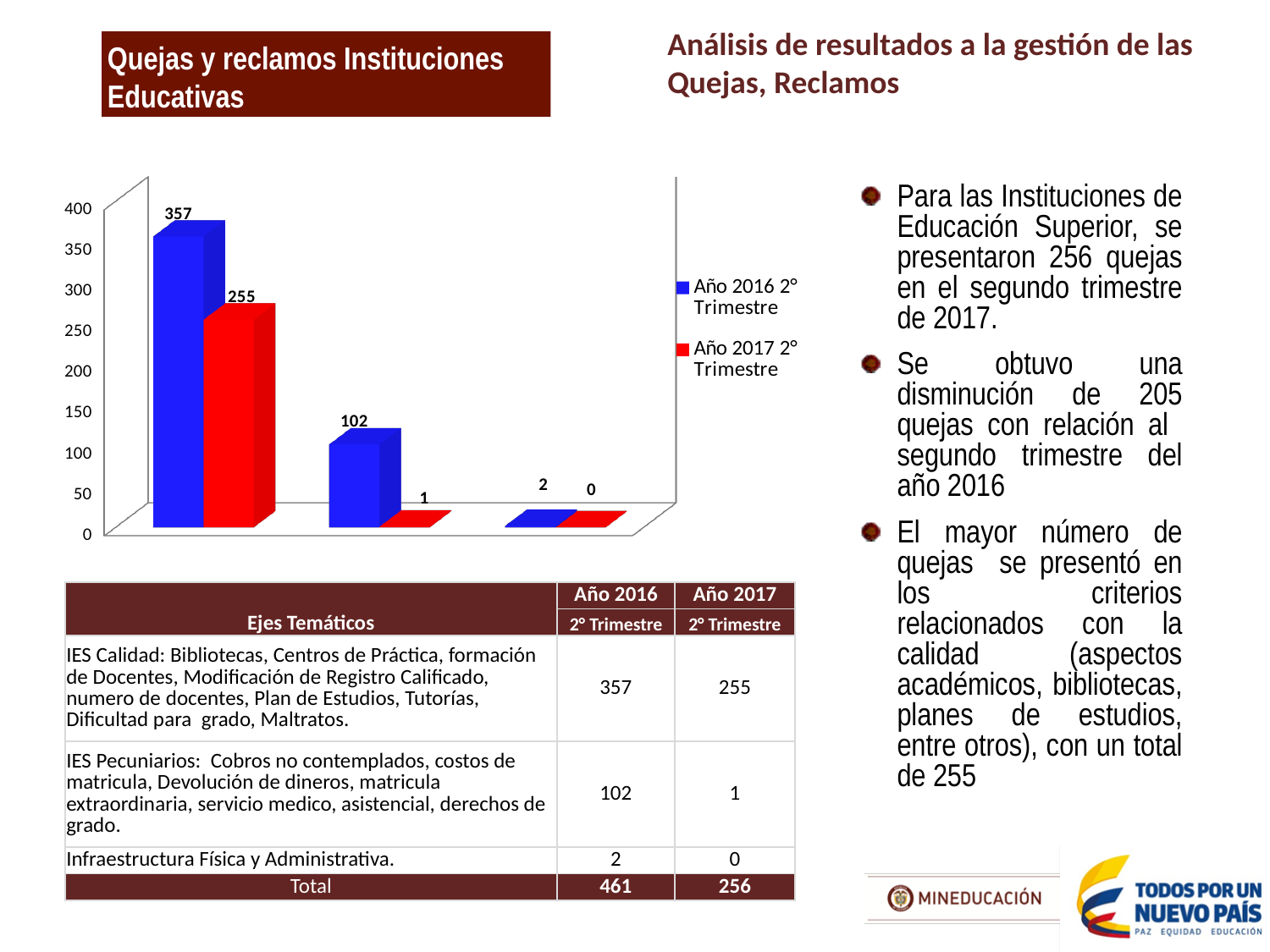
What is the lowest value shown in the chart? 0 Do the Año 2016 2° Trimestre values rise or fall from left to right across the chart? fall What is the difference between the Año 2016 2° Trimestre and Año 2017 2° Trimestre values in the first (leftmost) group of bars? 102 What is the value of the Año 2017 2° Trimestre bar in the first (leftmost) group of bars? 255 In the second (middle) group of bars, which series has the larger value, Año 2016 2° Trimestre or Año 2017 2° Trimestre? Año 2016 2° Trimestre What is the value of the Año 2017 2° Trimestre bar in the second (middle) group of bars? 1 How many groups of bars are plotted in the chart? 3 What kind of chart is shown on the slide? bar chart What is the value of the Año 2016 2° Trimestre bar in the first (leftmost) group of bars? 357 What is the difference between the Año 2016 2° Trimestre and Año 2017 2° Trimestre values in the second (middle) group of bars? 101 How many series does the chart legend list? 2 Which bar has the highest value in the chart? Año 2016 2° Trimestre in the first group (357)